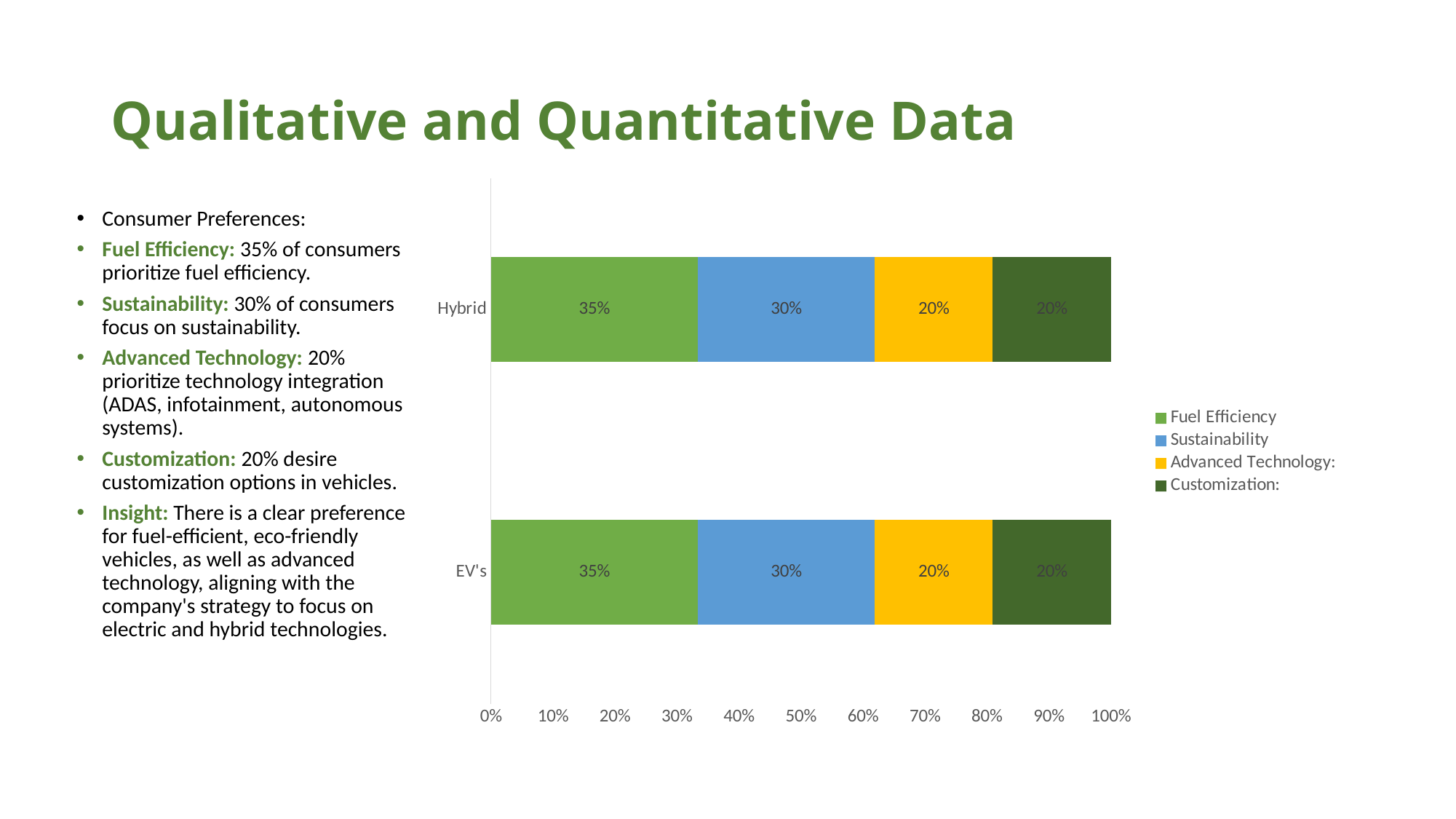
What is the Fuel Efficiency value for Hybrid? 35% What kind of chart is shown on the slide? Stacked bar chart What is the difference between the Fuel Efficiency and Sustainability values for EV's? 5% What is the Customization value for EV's? 20% Which is larger for Hybrid, Sustainability or Advanced Technology? Sustainability How many series does the legend list? 4 What is the total of the stacked bar for Hybrid? 105% Which series has the largest segment in the Hybrid bar? Fuel Efficiency What is the Sustainability value for EV's? 30% How many categories are shown on the chart? 2 Which colour represents Sustainability in the chart? Blue What is the Advanced Technology value for Hybrid? 20%